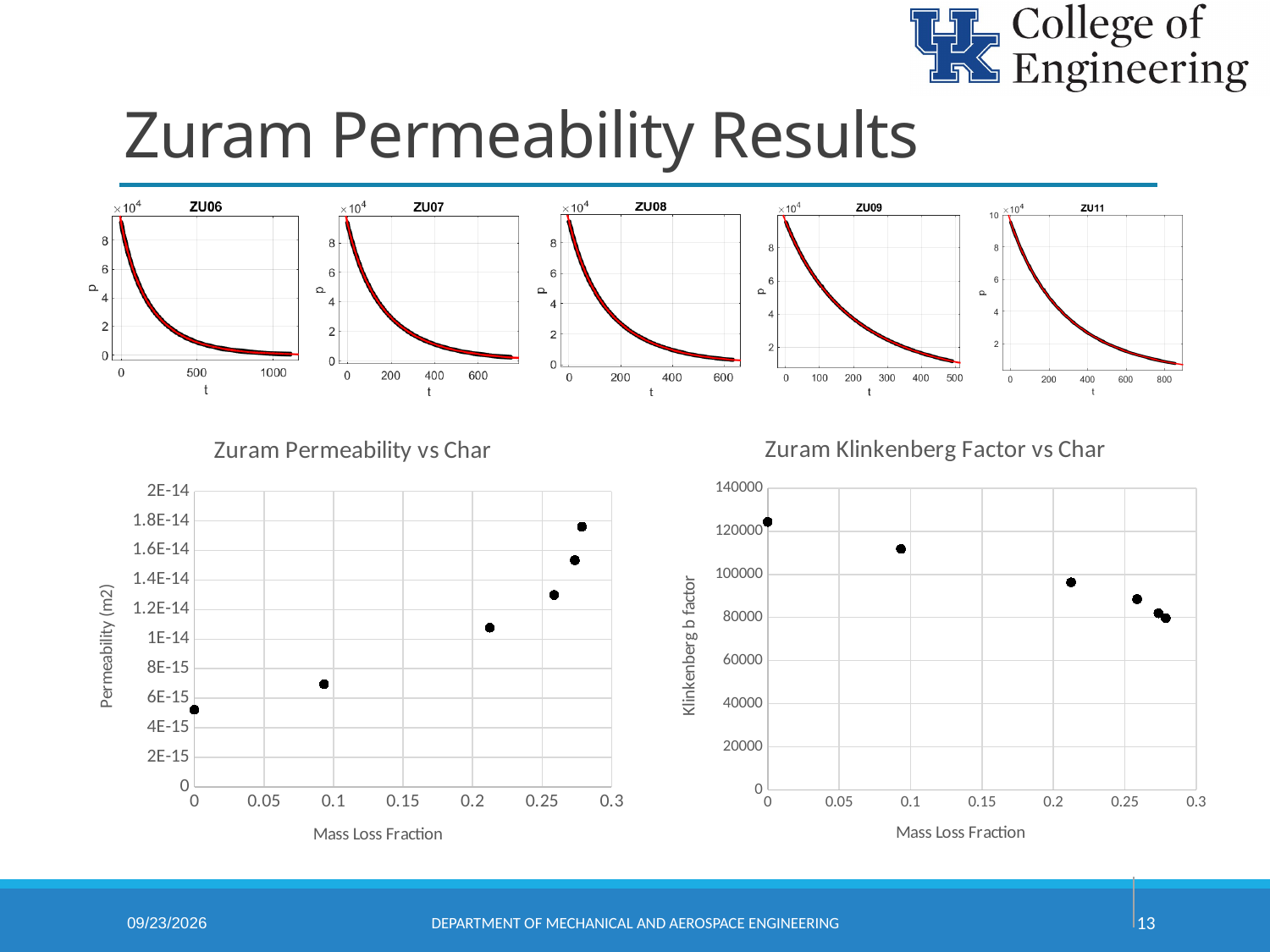
How many small pressure-versus-time plots are shown in the top row of the slide? 5 What kind of chart is the "Zuram Permeability vs Char" chart? Scatter chart In the "Zuram Permeability vs Char" chart, do the permeability values rise or fall as mass loss fraction increases? Rise What is the y-axis title of the "Zuram Permeability vs Char" chart? Permeability (m2) In the "Zuram Klinkenberg Factor vs Char" chart, do the Klinkenberg b factor values rise or fall as mass loss fraction increases? Fall How many data points are plotted in the "Zuram Klinkenberg Factor vs Char" chart? 6 What is the x-axis title of the "Zuram Klinkenberg Factor vs Char" chart? Mass Loss Fraction In the "Zuram Permeability vs Char" chart, is the highest plotted permeability value greater or less than 1.6E-14? greater In the "Zuram Klinkenberg Factor vs Char" chart, is the Klinkenberg b factor at a mass loss fraction of about 0.21 greater or less than 100000? less In the "Zuram Permeability vs Char" chart, is the permeability at a mass loss fraction of 0 greater or less than 6E-15? less How many data points are plotted in the "Zuram Permeability vs Char" chart? 6